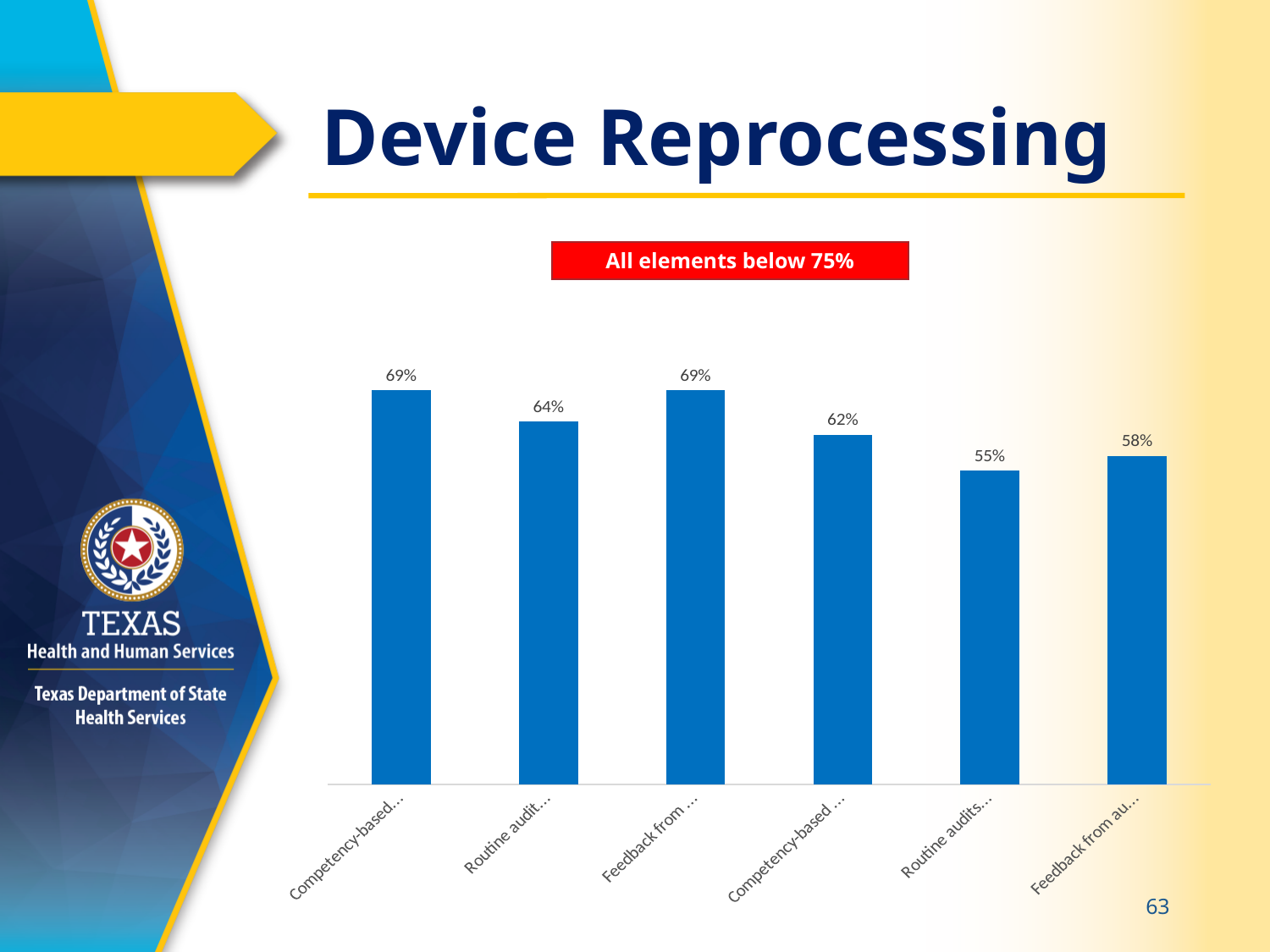
Which bar has the lowest value: the fifth bar or the sixth bar? the fifth bar What is the difference in percentage points between the first bar (69%) and the fifth bar (55%)? 14 percentage points What is the highest value shown in the chart? 69% What is the value of the last (rightmost) bar in the chart? 58% What is the title of the slide containing the chart? Device Reprocessing What is the value of the first (leftmost) bar in the chart? 69% What is the lowest value shown in the chart? 55% What is the value of the second bar from the left in the chart? 64% What does the red annotation box above the chart say? All elements below 75% What type of chart is shown on the slide? bar chart What is the value of the fourth bar from the left in the chart? 62% How many bars are plotted in the chart? 6